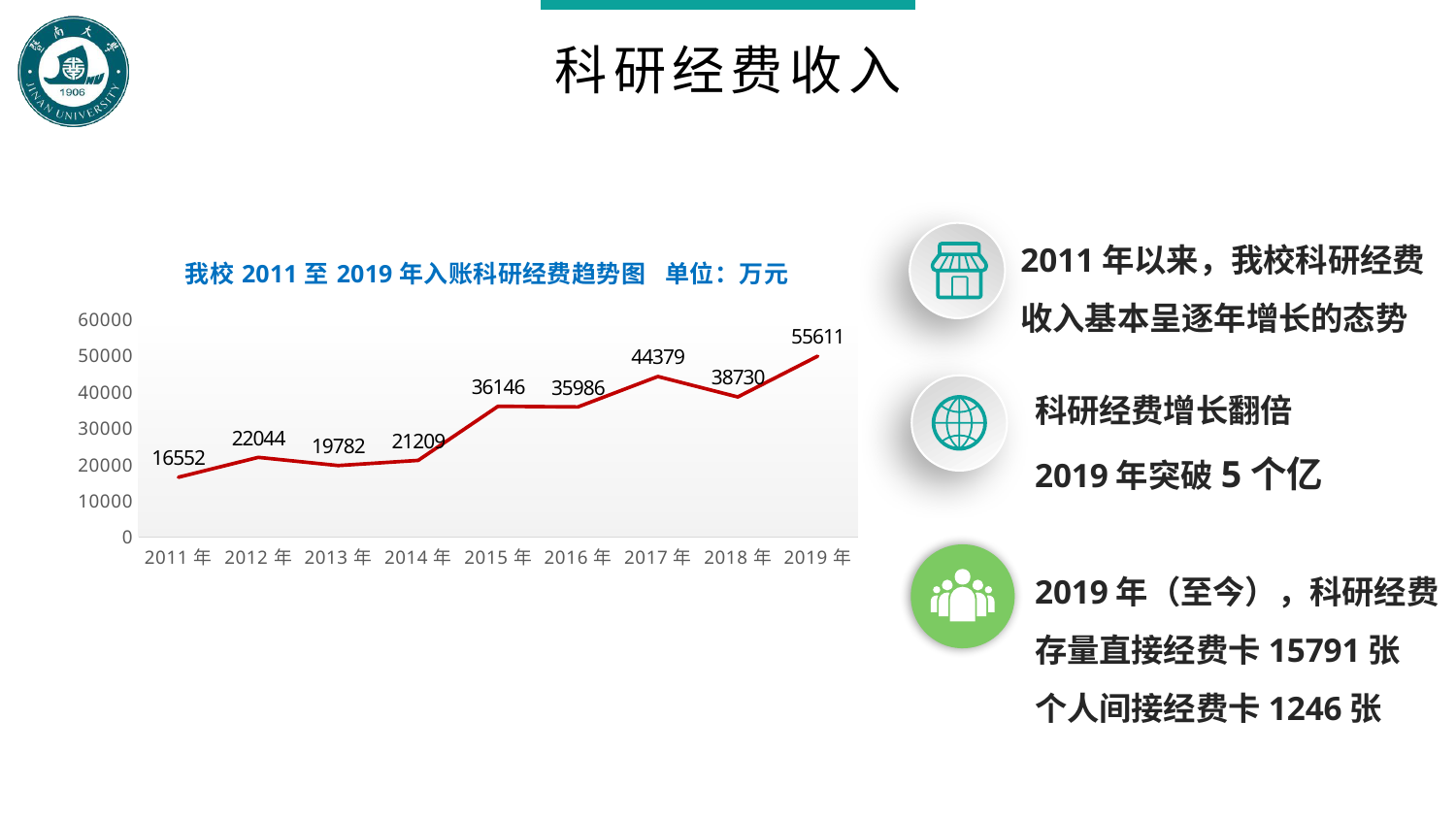
How many years are plotted in the line chart? 9 Is the value for 2017年 greater or less than 40000? greater What kind of chart is shown on the slide? line chart What unit is stated in the chart title? 万元 Which year has the lowest value in the line chart? 2011年 What is the difference between the values for 2012年 and 2013年? 2262 What is the value for 2011年 in the line chart? 16552 What is the difference between the values for 2019年 and 2018年? 16881 Which year has the highest value in the line chart? 2019年 What is the value for 2015年 in the line chart? 36146 What is the value for 2018年 in the line chart? 38730 Which is larger, the value for 2015年 or the value for 2016年? 2015年